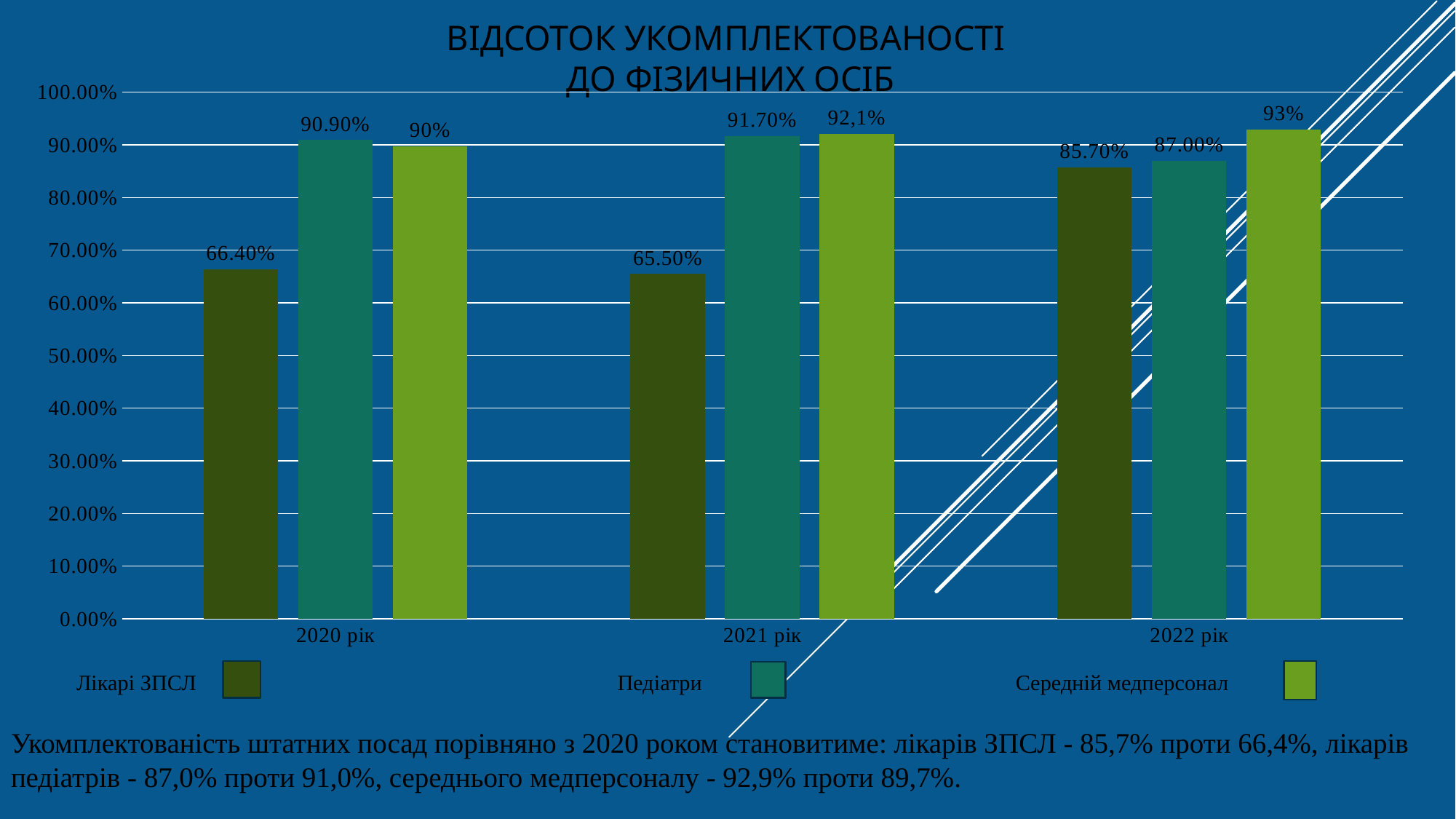
What is the value for Лікарі ЗПСЛ in 2022 рік? 85.70% Which is larger in 2022 рік: Педіатри or Лікарі ЗПСЛ? Педіатри How many years are shown on the x axis? 3 How many series does the legend list? 3 What is the difference between the Лікарі ЗПСЛ values for 2022 рік and 2020 рік? 19.30% Is the value for Лікарі ЗПСЛ in 2021 рік greater or less than 70.00%? less What kind of chart is shown on the slide? bar chart In which year is the value for Лікарі ЗПСЛ the lowest? 2021 рік What is the value for Педіатри in 2021 рік? 91.70% What is the value for Лікарі ЗПСЛ in 2020 рік? 66.40% What is the value for Середній медперсонал in 2022 рік? 93% In which year is the value for Середній медперсонал the highest? 2022 рік